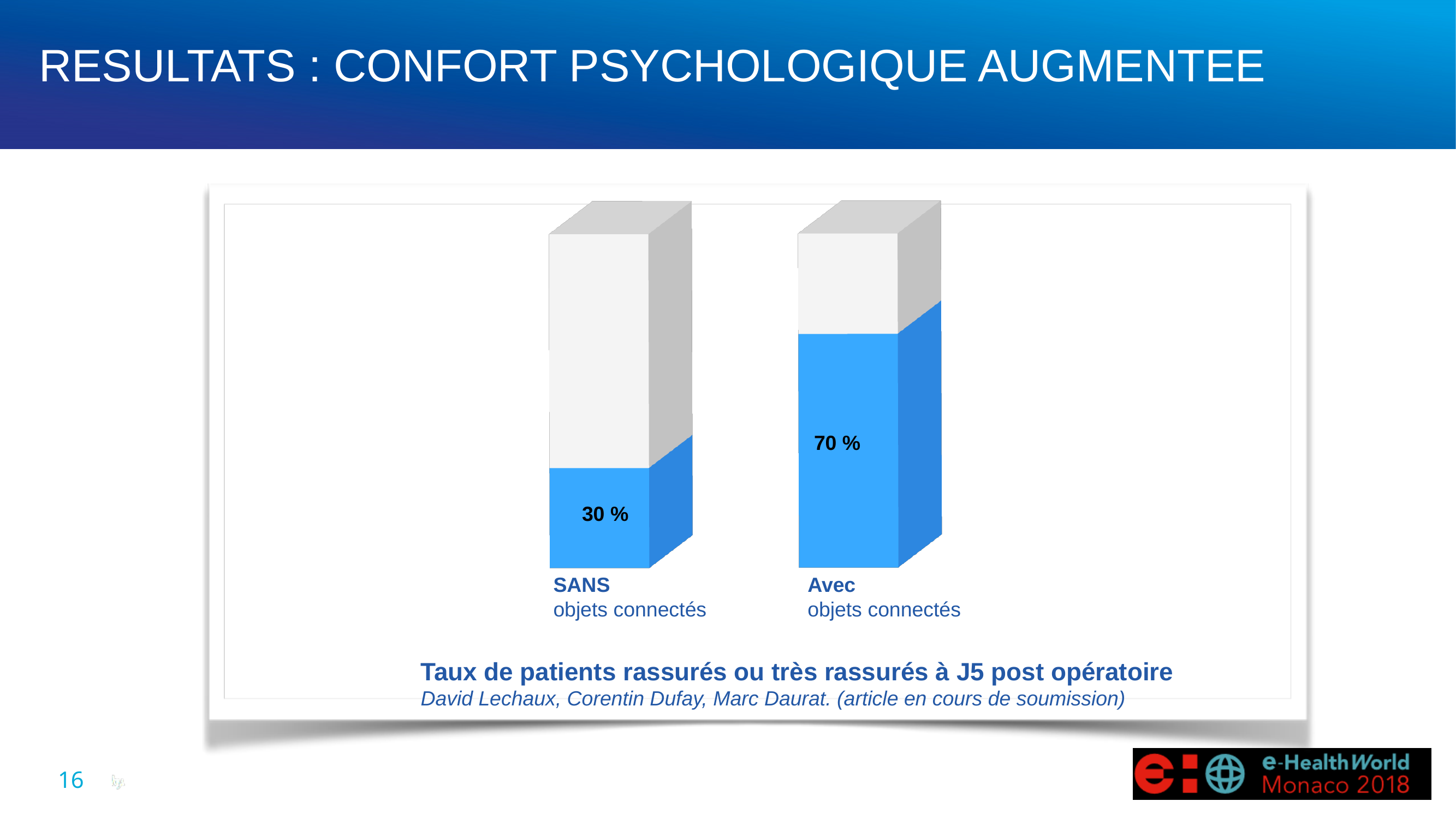
What is the value for 'Avec objets connectés'? 70 % Which category has the lowest value? SANS objets connectés What is the value for 'SANS objets connectés'? 30 % Which category has the highest value? Avec objets connectés What is the caption of the chart? Taux de patients rassurés ou très rassurés à J5 post opératoire What kind of chart is shown on the slide? bar chart What is the difference between the values for 'Avec objets connectés' and 'SANS objets connectés'? 40 % How many categories are shown in the chart? 2 What colour is the filled portion of the bars? blue Do the values rise or fall from 'SANS objets connectés' to 'Avec objets connectés'? rise Which is larger: the value for 'SANS objets connectés' or 'Avec objets connectés'? Avec objets connectés